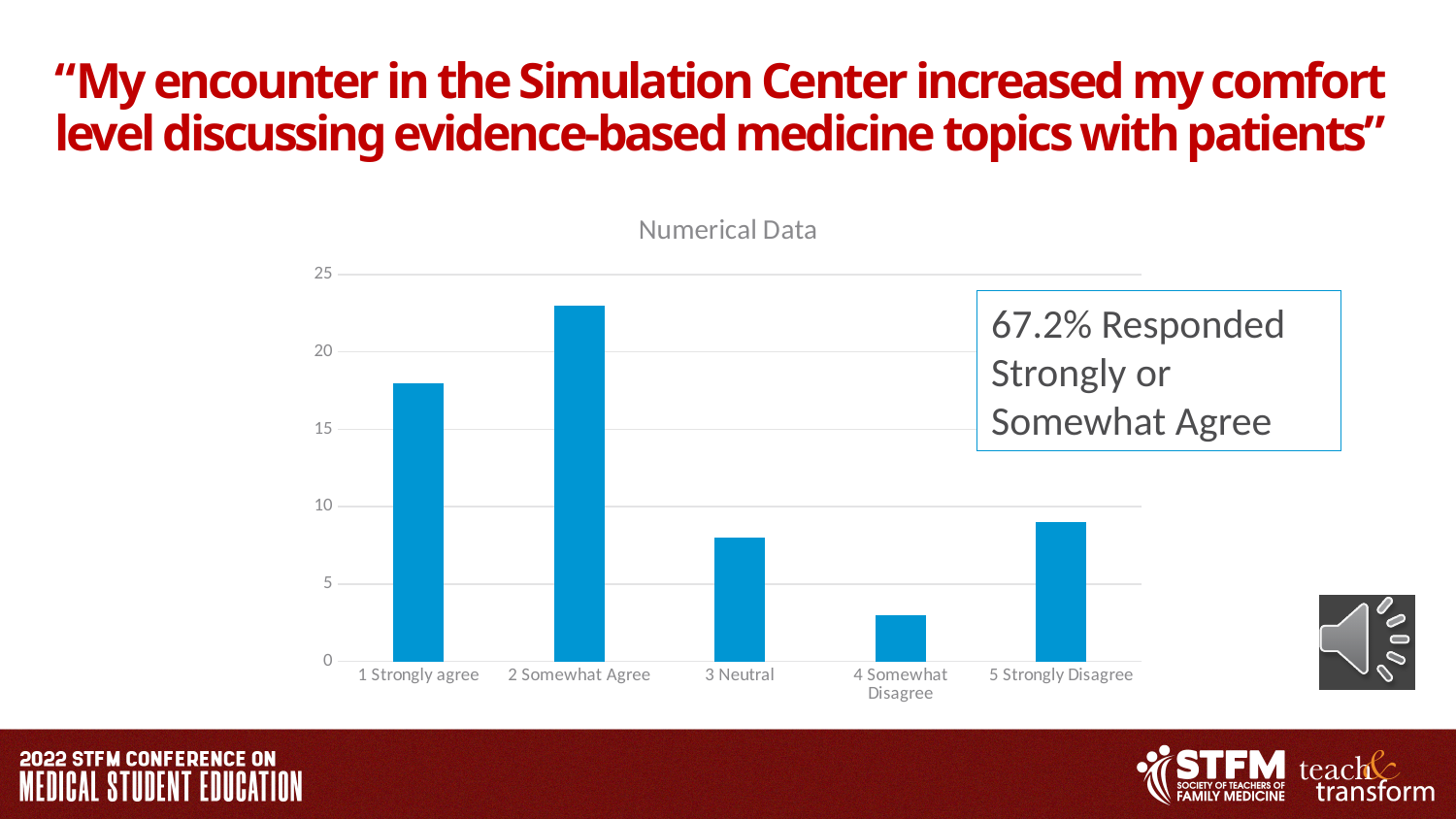
What kind of chart is shown on the slide? bar chart How many categories are shown on the x axis of the chart? 5 According to the text box on the chart, what percentage responded Strongly or Somewhat Agree? 67.2% Is the value for 4 Somewhat Disagree greater or less than 5? less Which category has the lowest bar? 4 Somewhat Disagree Which is larger, the value for 1 Strongly agree or the value for 5 Strongly Disagree? 1 Strongly agree Is the value for 1 Strongly agree greater or less than 15? greater Which category has the highest bar? 2 Somewhat Agree Is the value for 2 Somewhat Agree greater or less than 20? greater What is the title of the chart? Numerical Data